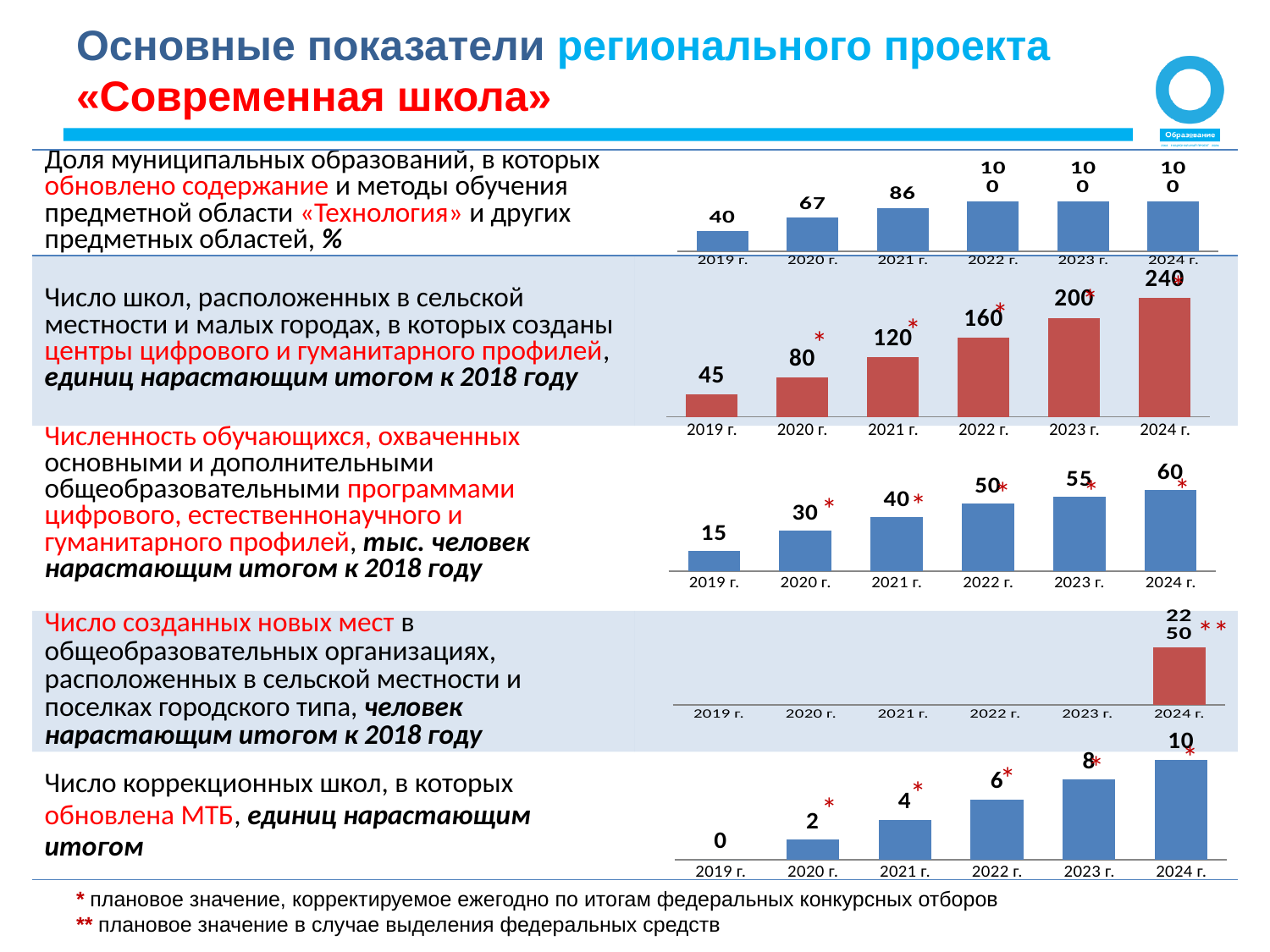
In the third chart from the top (number of students, thousand people), which year has the lowest value? 2019 г. In the bottom chart (number of correctional schools with updated MTB), what is the value for 2021 г.? 4 In the second chart from the top (number of rural schools with digital and humanities centres), what is the value for 2022 г.? 160 In the fourth chart from the top (number of new places created), what is the value for 2024 г.? 2250 In the third chart from the top (number of students, thousand people), what is the value for 2023 г.? 55 In the third chart from the top (number of students), do the values rise or fall from 2019 г. to 2024 г.? rise In the top chart (share of municipalities, %), what is the value for 2021 г.? 86 In the bottom chart (number of correctional schools), which is larger: the value for 2022 г. or 2020 г.? 2022 г. How many years are shown on the x axis of the bottom chart (number of correctional schools)? 6 In the second chart from the top (number of rural schools with centres), what is the difference between the 2024 г. and 2019 г. values? 195 In the second chart from the top (number of rural schools with centres), which year has the highest value? 2024 г. In the top chart (share of municipalities with updated 'Технология' content, %), what is the value for 2020 г.? 67